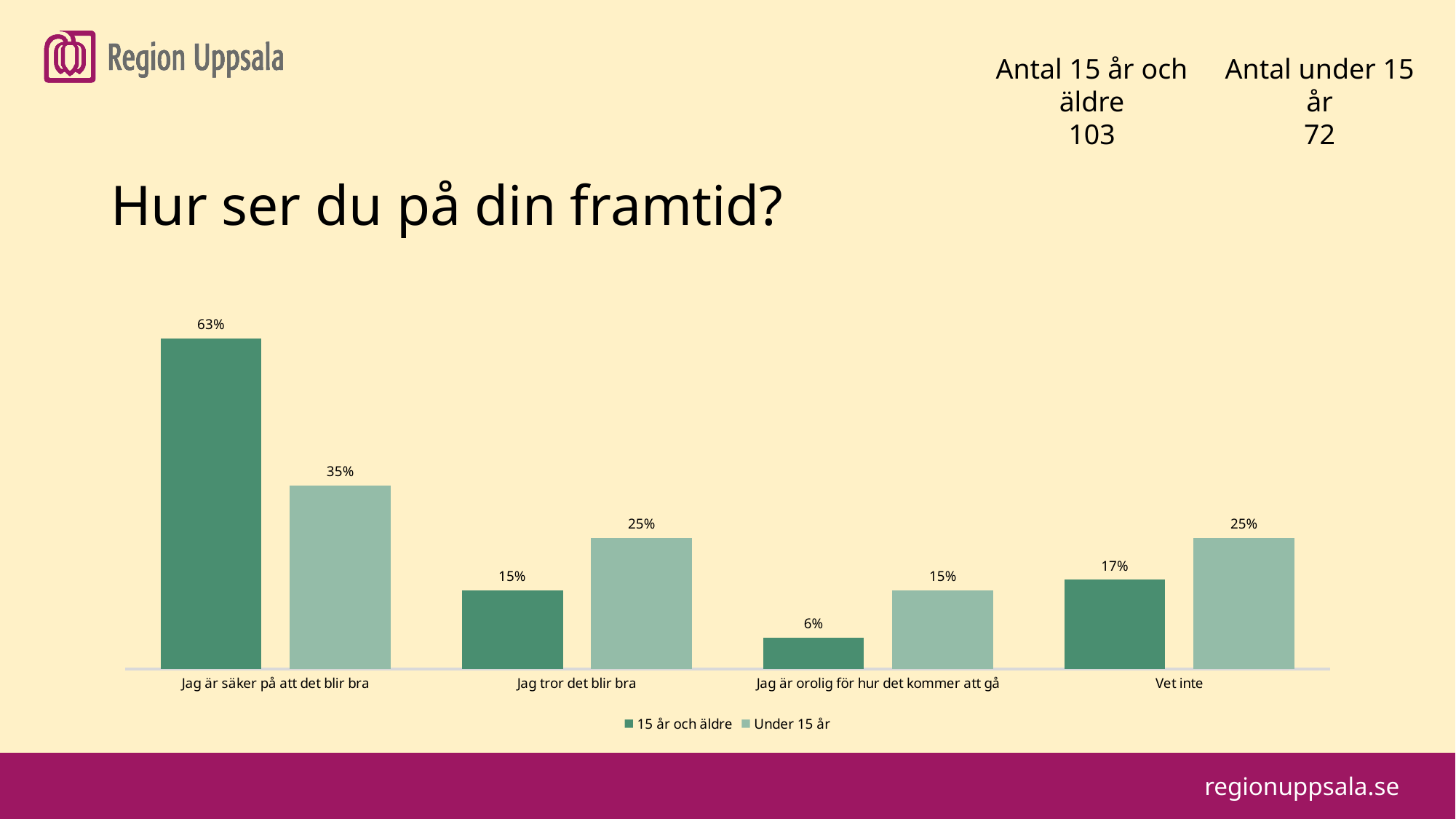
Which category has the highest value for the 15 år och äldre series? Jag är säker på att det blir bra What percentage of respondents under 15 (Under 15 år) answered "Jag tror det blir bra"? 25% What is the difference between the 15 år och äldre and Under 15 år values for "Jag är säker på att det blir bra"? 28 percentage points How many answer categories are shown on the x axis? 4 How many series does the legend list? 2 What is the value for "Jag är orolig för hur det kommer att gå" in the 15 år och äldre series? 6% What is the title of the chart on the slide? Hur ser du på din framtid? Which category has the lowest value for the Under 15 år series? Jag är orolig för hur det kommer att gå What kind of chart is shown on the slide? Bar chart What percentage of respondents aged 15 and older (15 år och äldre) answered "Jag är säker på att det blir bra"? 63% For "Vet inte", which series has the larger value: 15 år och äldre or Under 15 år? Under 15 år What is the value for "Vet inte" in the Under 15 år series? 25%